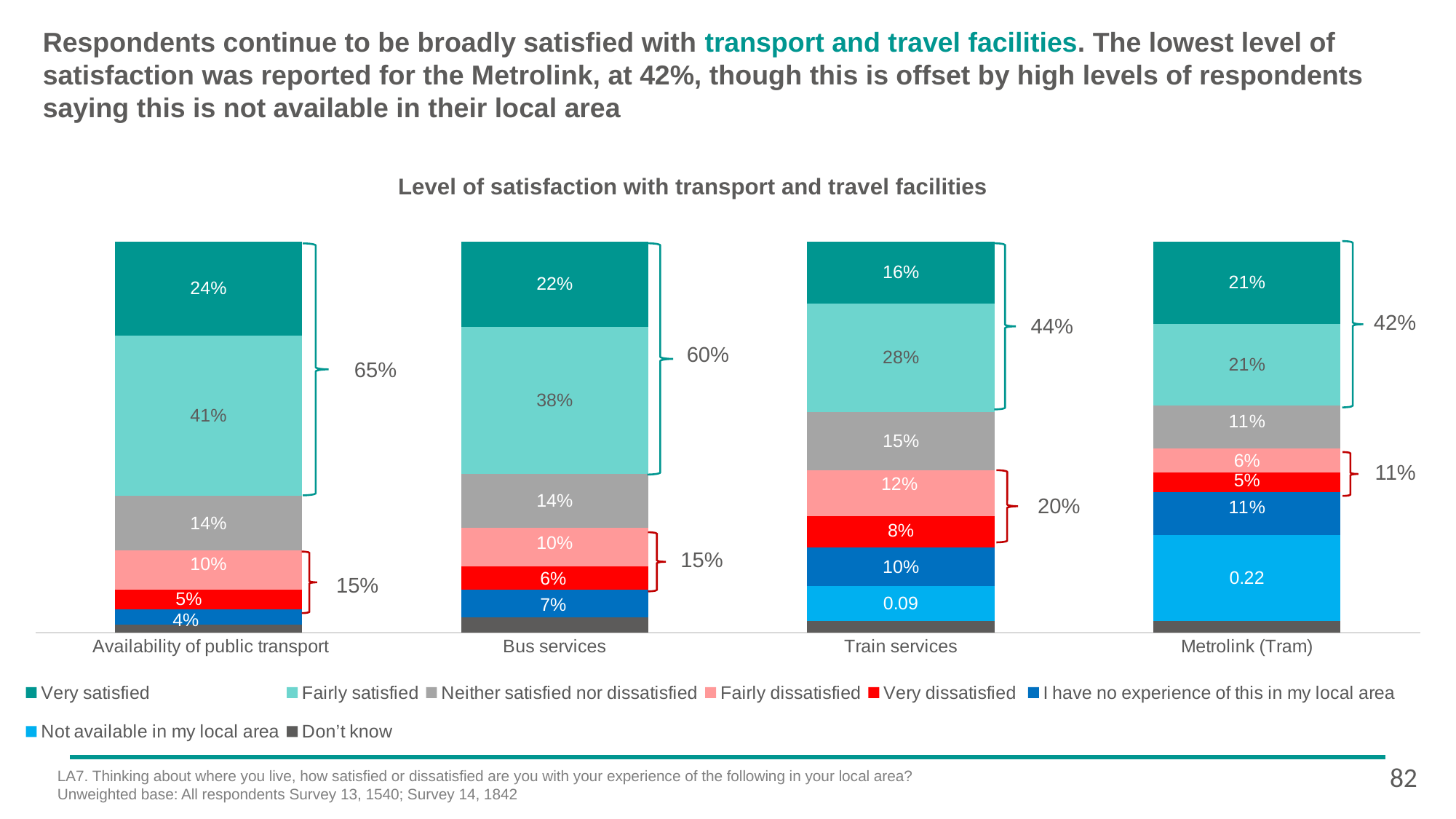
What is the Not available in my local area value for Metrolink (Tram)? 0.22 Which is larger: the Neither satisfied nor dissatisfied value for Train services or for Metrolink (Tram)? Train services Which category has the highest Fairly satisfied value? Availability of public transport Which category has the lowest Very satisfied value? Train services What is the Very satisfied value for Availability of public transport? 24% What is the Very dissatisfied value for Train services? 8% What kind of chart is shown on the slide? Stacked bar chart What is the title of the chart? Level of satisfaction with transport and travel facilities What is the Fairly satisfied value for Bus services? 38% What is the difference between the Fairly satisfied values for Availability of public transport and Train services? 13% How many series does the legend list? 8 How many categories are shown along the x axis? 4